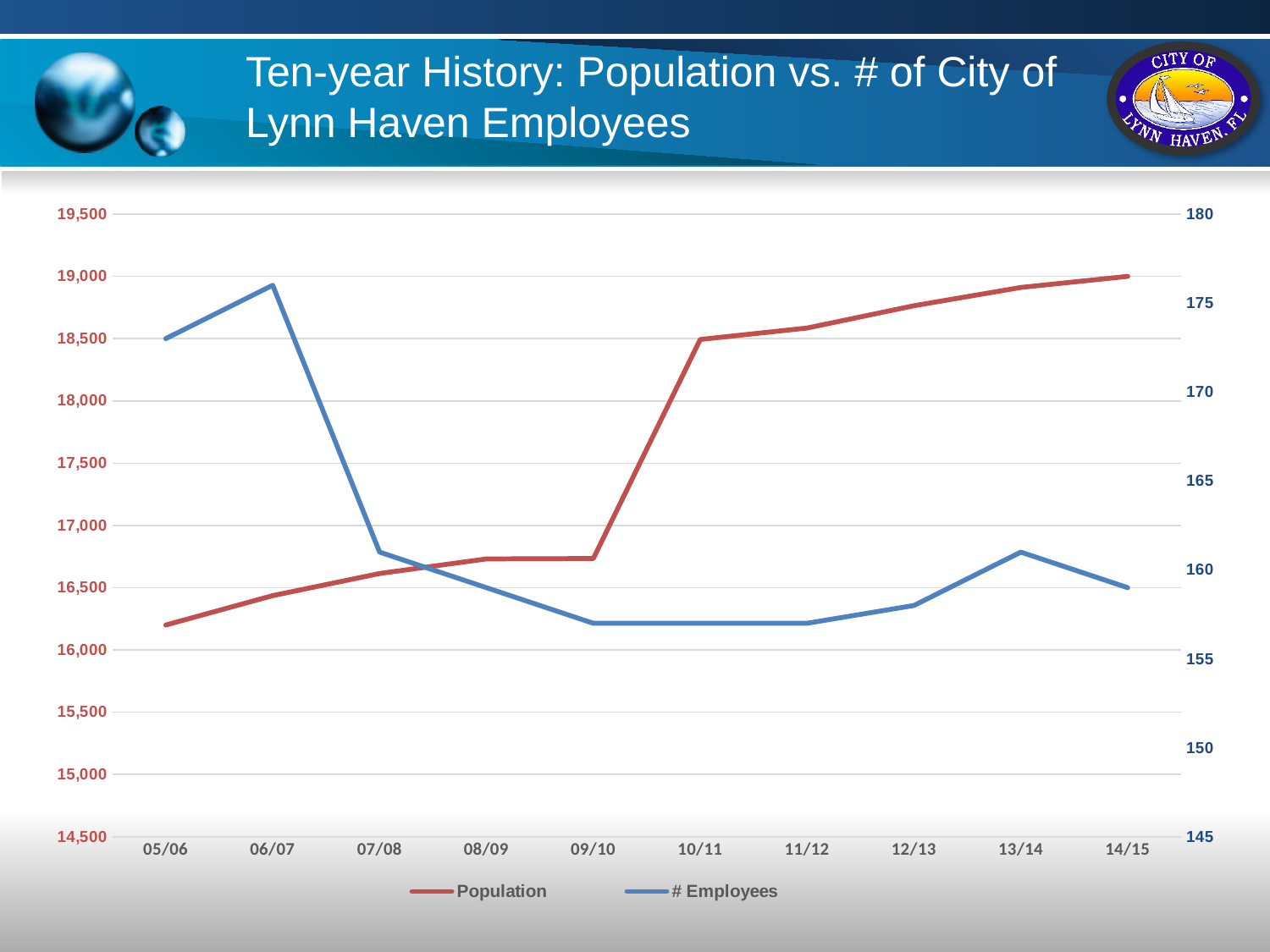
In which year is the Population value highest? 14/15 How many fiscal years are plotted along the x axis? 10 How many series does the legend list? 2 What type of chart is shown on the slide? line chart Is the # Employees value for 07/08 greater or less than 165? less Does the Population line generally rise or fall from 05/06 to 14/15? rise In which year is the # Employees value highest? 06/07 In which year is the Population value lowest? 05/06 Which year has the larger # Employees value, 13/14 or 14/15? 13/14 Is the Population value for 05/06 greater or less than 16,500? less Is the # Employees value for 06/07 greater or less than 175? greater What colour is the Population line? red